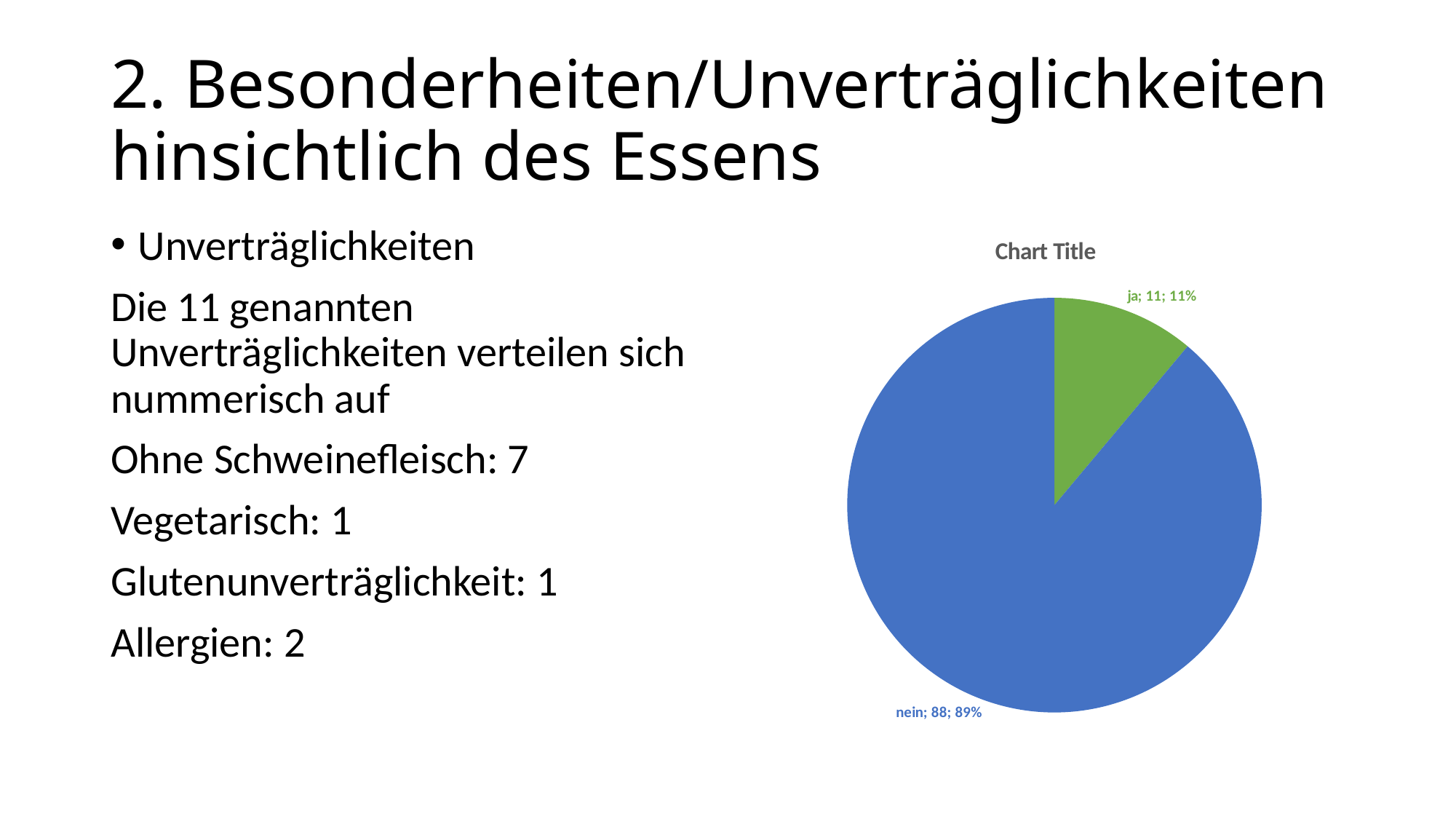
Which slice is the smallest? ja What is the difference between the "nein" and "ja" values? 77 Which slice is the largest? nein What is the value for the "nein" slice? 88 What colour is the "ja" slice? green What kind of chart is shown on the slide? pie chart What is the value for the "ja" slice? 11 Which is larger, the "ja" slice or the "nein" slice? nein What is the title of the chart? Chart Title What share of the pie does the "ja" slice represent? 11% What share of the pie does the "nein" slice represent? 89% How many slices does the pie chart have? 2